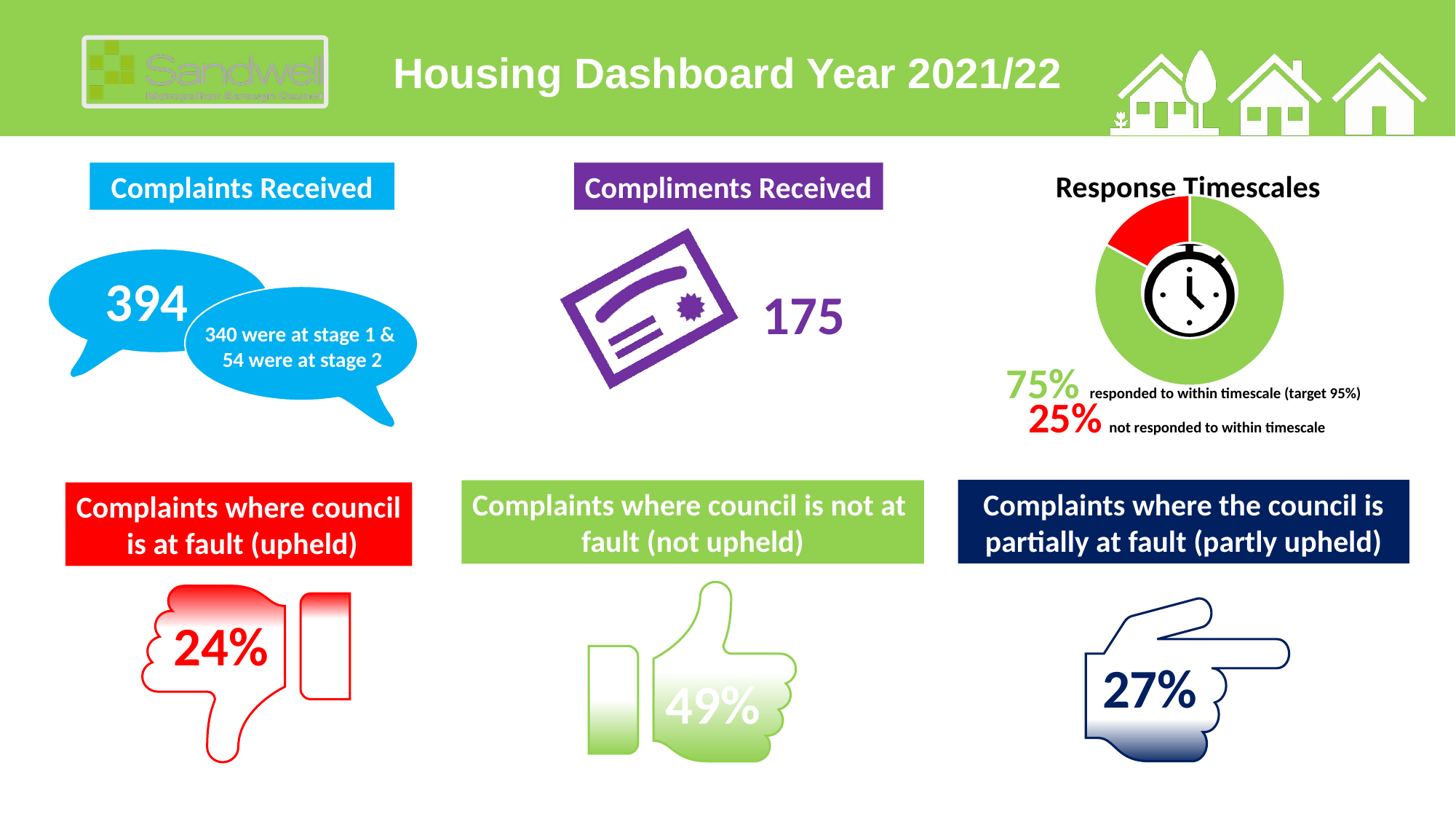
In the Response Timescales pie chart, what is the difference in percentage points between the responded-within-timescale share and the not-responded share? 50 In the Response Timescales pie chart, which slice is the largest? responded to within timescale What kind of chart is the Response Timescales chart? pie chart In the Response Timescales pie chart, what share of responses were responded to within timescale? 75% In the Response Timescales pie chart, which is larger: the share responded to within timescale or the share not responded to within timescale? responded to within timescale In the Response Timescales pie chart, how many slices are there? 2 In the Response Timescales pie chart, which slice is the smallest? not responded to within timescale In the Response Timescales pie chart, what colour is the slice for responses not responded to within timescale? red In the Response Timescales pie chart, is the share responded to within timescale greater or less than 50%? greater In the Response Timescales pie chart, what share of responses were not responded to within timescale? 25% What target percentage is stated next to the Response Timescales pie chart for responses within timescale? 95%